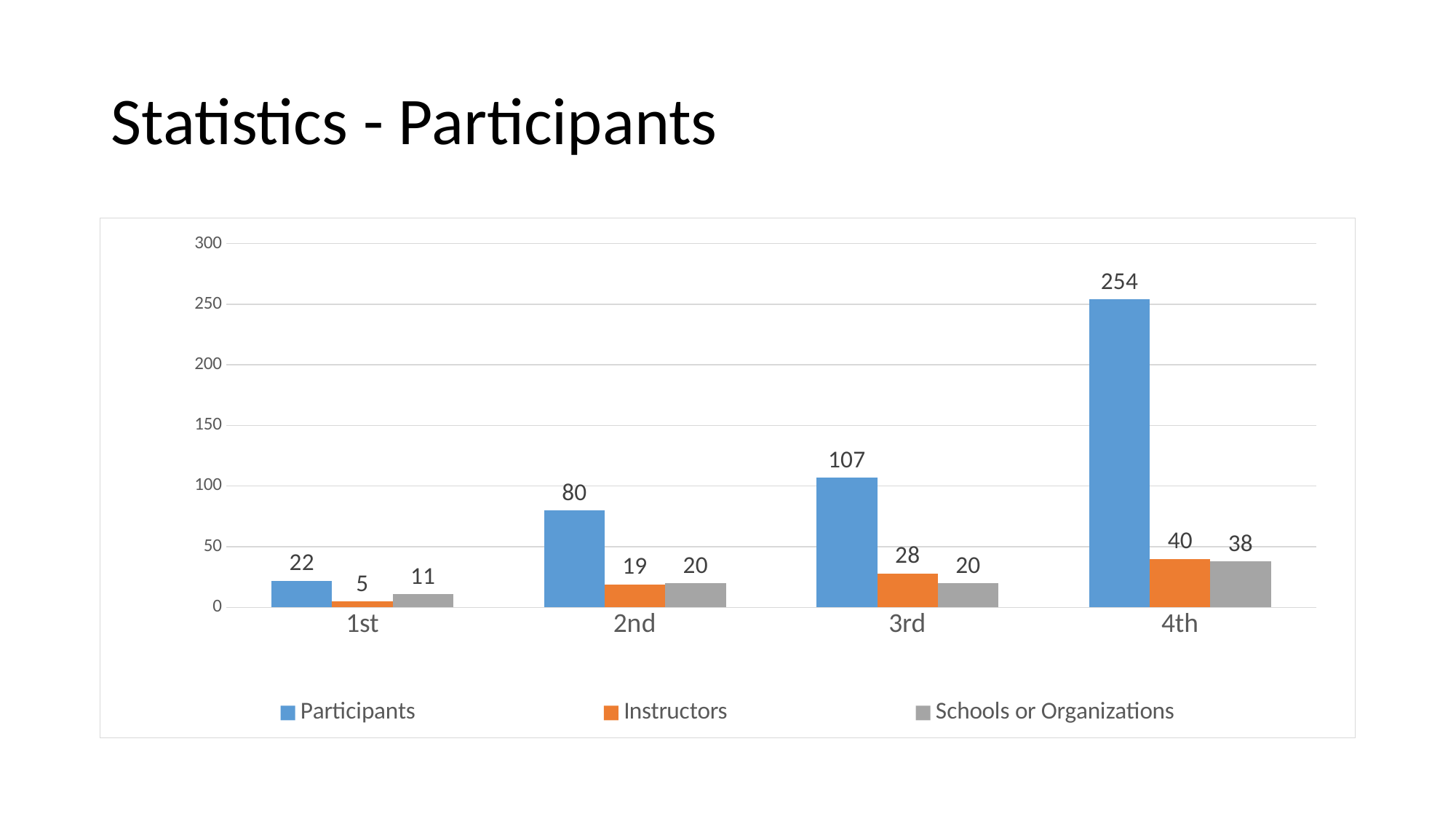
What is the value for Schools or Organizations in the 1st category? 11 Which category has the highest value for Participants? 4th Which category has the lowest value for Instructors? 1st Do the Participants values rise or fall from 1st to 4th? rise Which is larger in the 2nd category: Instructors or Schools or Organizations? Schools or Organizations What kind of chart is shown on the slide? bar chart What is the difference between Participants in the 4th and 3rd categories? 147 How many categories are shown on the x axis? 4 How many series does the legend list? 3 Is the value for Participants in the 3rd category greater or less than 100? greater What is the value for Participants in the 4th category? 254 What is the value for Instructors in the 2nd category? 19